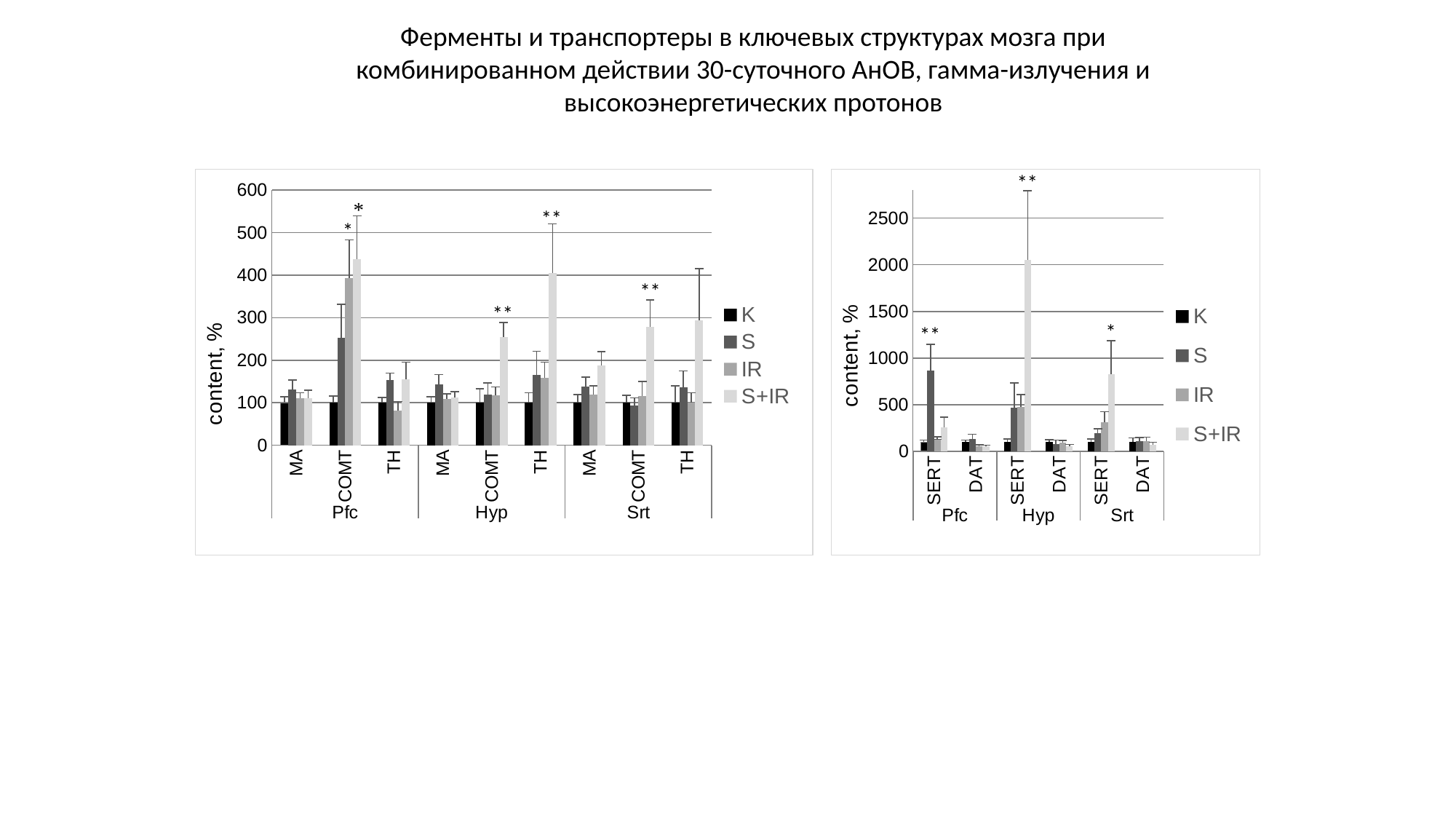
What kind of chart is the left chart? bar chart In the right chart, which bar is the highest overall? S+IR for SERT in Hyp How many series does the legend of the right chart list? 4 What are the series names in the legend of the left chart? K, S, IR, S+IR In the left chart, is the S+IR value for COMT in Pfc greater or less than 400? greater How many category groups (bar clusters) are shown on the x axis of the left chart? 9 In the right chart, is the S+IR value for SERT in Hyp greater or less than 1500? greater What is the y-axis label of the right chart? content, % In the right chart, is the S value for SERT in Pfc greater or less than 500? greater How many category groups (bar clusters) are shown on the x axis of the right chart? 6 In the right chart, which is larger for SERT in Srt: the S value or the S+IR value? S+IR